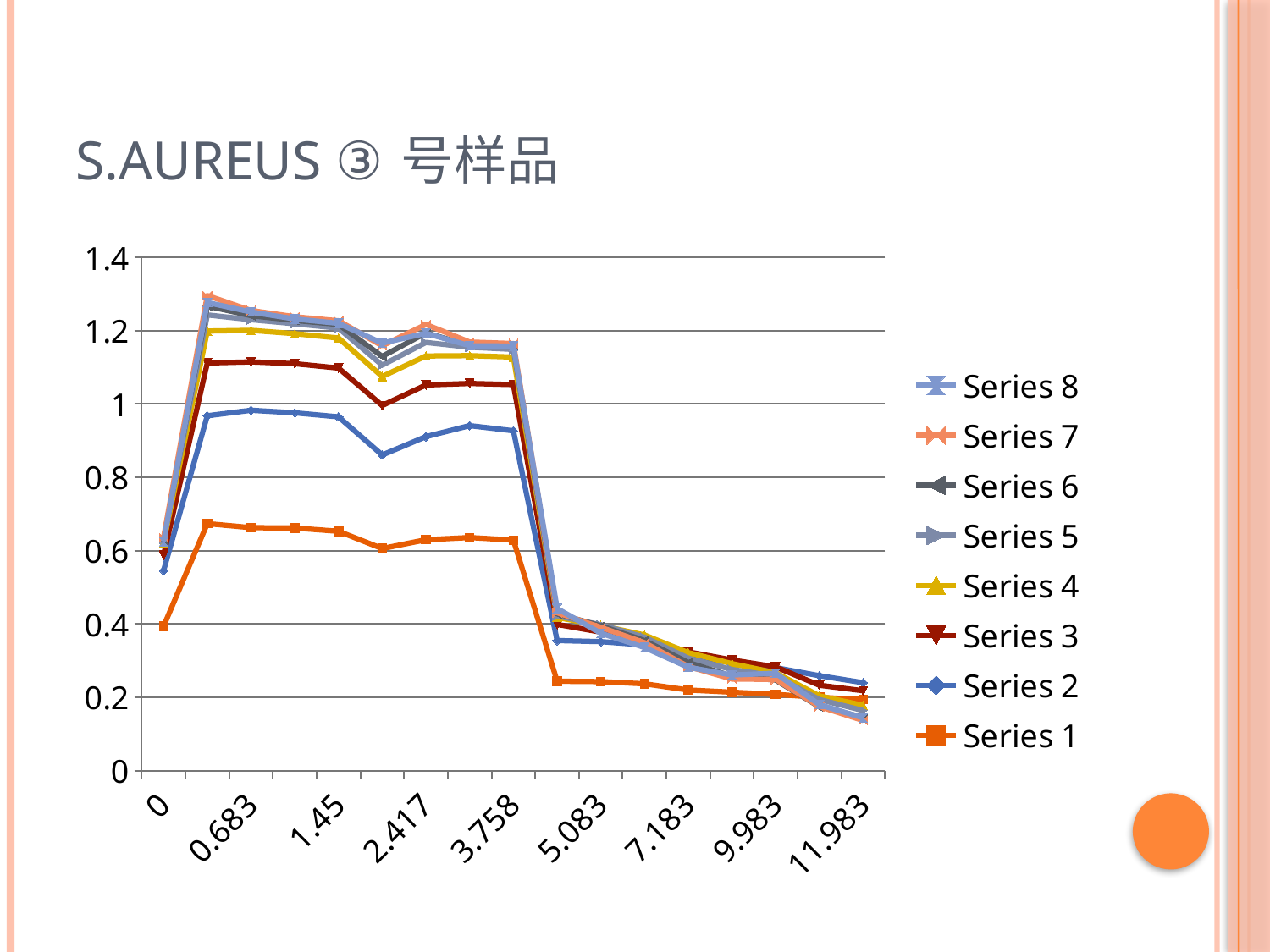
Is the value of Series 1 at x = 5.083 greater or less than 0.4? less Is the value of Series 1 at x = 0.683 greater or less than 0.6? greater Which series is plotted with square markers in orange? Series 1 What is the title of the slide containing the chart? S.AUREUS ③ 号样品 Do the values of Series 1 rise or fall between x = 3.758 and x = 5.083? fall Is the value of Series 2 at x = 0 greater or less than 0.6? less What kind of chart is shown on the slide? line chart How many series does the legend list? 8